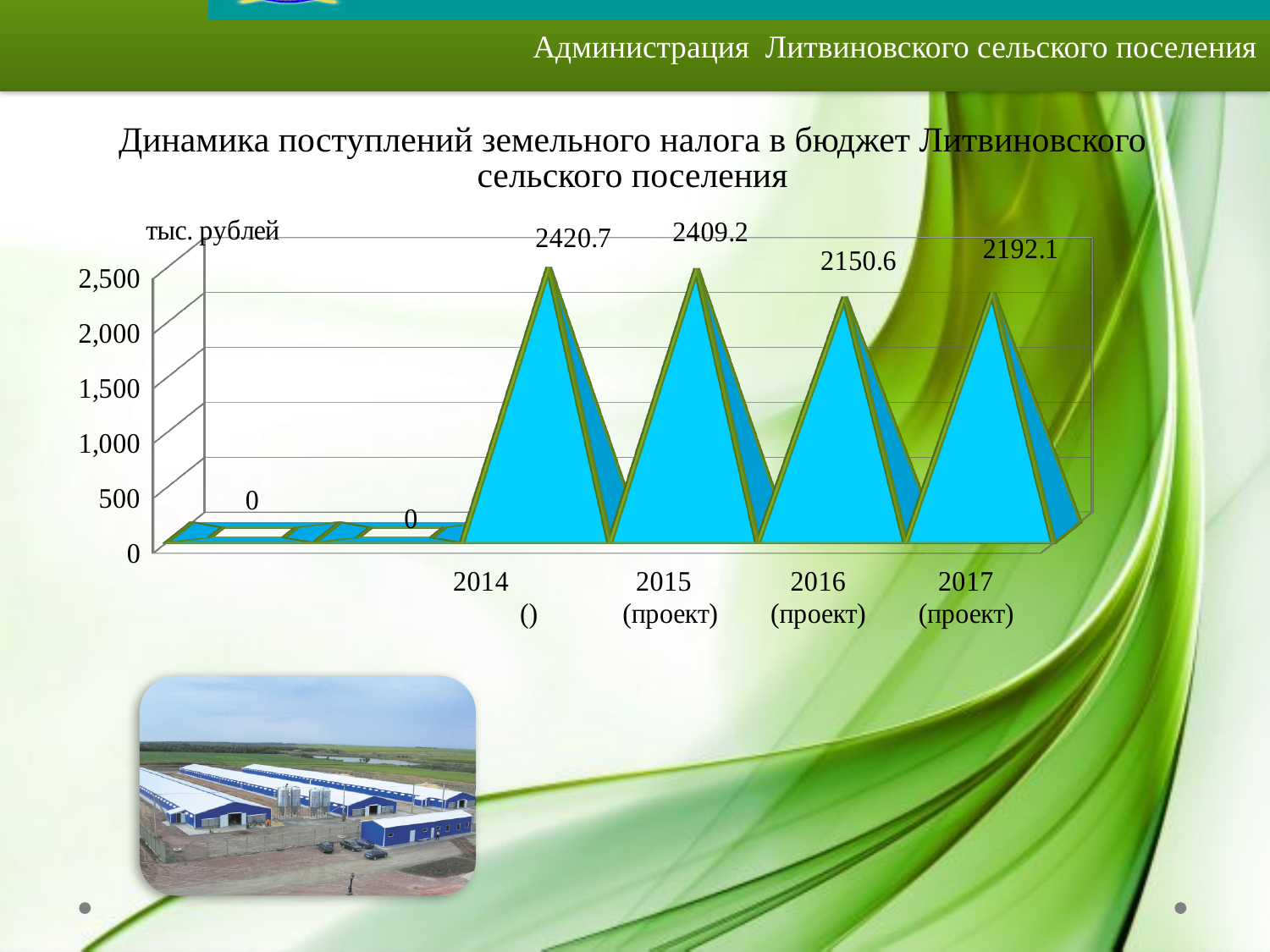
Which is larger, the value for 2015 (проект) or 2016 (проект)? 2015 (проект) What is the value for 2014 ()? 2420.7 What is the value for 2015 (проект)? 2409.2 Is the value for 2014 () greater or less than 2,000? greater What is the value for 2016 (проект)? 2150.6 What is the difference between the values for 2014 () and 2016 (проект)? 270.1 What is the difference between the values for 2017 (проект) and 2016 (проект)? 41.5 Which year has the highest value? 2014 () What is the value for 2017 (проект)? 2192.1 What kind of chart is shown on the slide? bar chart Among the years 2014 to 2017, which has the lowest value? 2016 (проект) What unit is shown on the vertical axis label? тыс. рублей